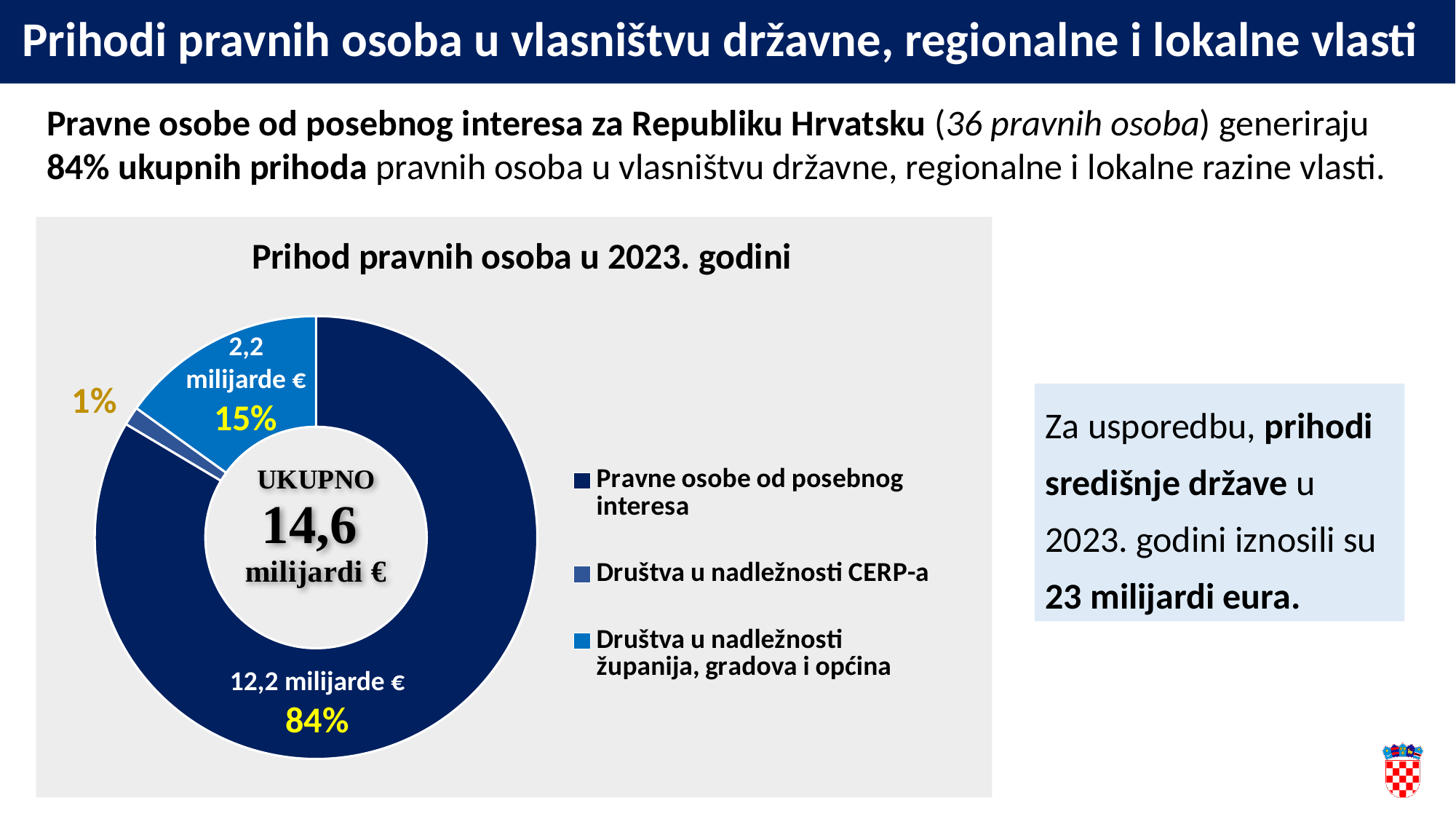
How many slices does the chart have? 3 What is the value shown for 'Društva u nadležnosti županija, gradova i općina'? 2,2 milijarde € What is the title of the chart? Prihod pravnih osoba u 2023. godini What share of the chart is 'Društva u nadležnosti županija, gradova i općina'? 15% How many entries does the legend list? 3 Which category has the smallest slice? Društva u nadležnosti CERP-a What share of the chart is 'Društva u nadležnosti CERP-a'? 1% What kind of chart is shown on the slide? Pie chart (donut) Which category has the largest slice? Pravne osobe od posebnog interesa What is the value shown for 'Pravne osobe od posebnog interesa'? 12,2 milijarde € What share of the chart is 'Pravne osobe od posebnog interesa'? 84% What total is shown in the centre of the chart? 14,6 milijardi €